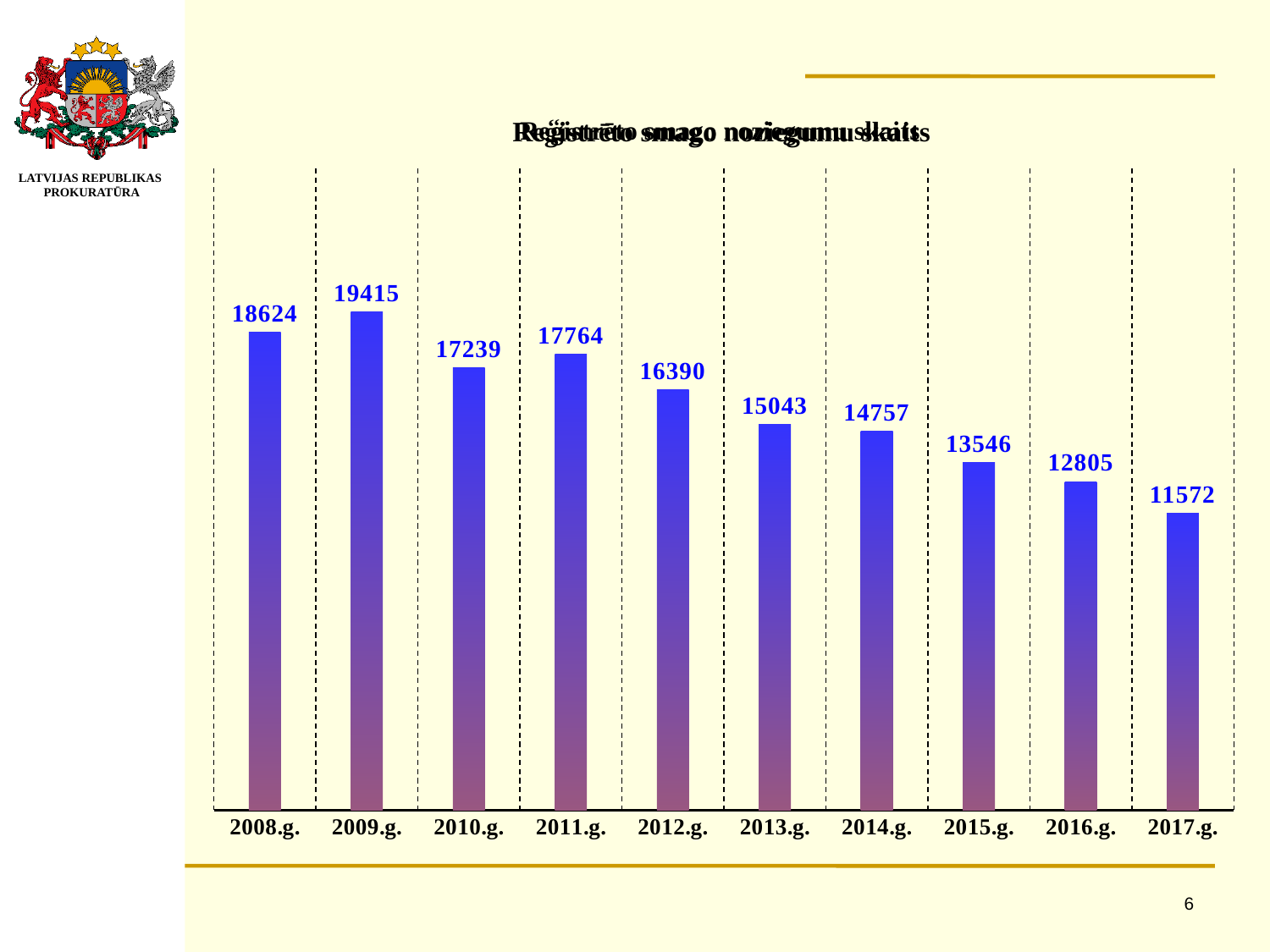
How many years are shown on the x axis? 10 Do the values generally rise or fall from 2009.g. to 2017.g.? fall What is the difference between the values for 2009.g. and 2017.g.? 7843 Which is larger, the value for 2015.g. or the value for 2016.g.? 2015.g. Which year has the highest value? 2009.g. What is the value for 2013.g.? 15043 What is the difference between the values for 2008.g. and 2009.g.? 791 What kind of chart is this? bar chart What is the value for 2017.g.? 11572 Which year has the lowest value? 2017.g. Which is larger, the value for 2010.g. or the value for 2011.g.? 2011.g. What is the value for 2009.g.? 19415